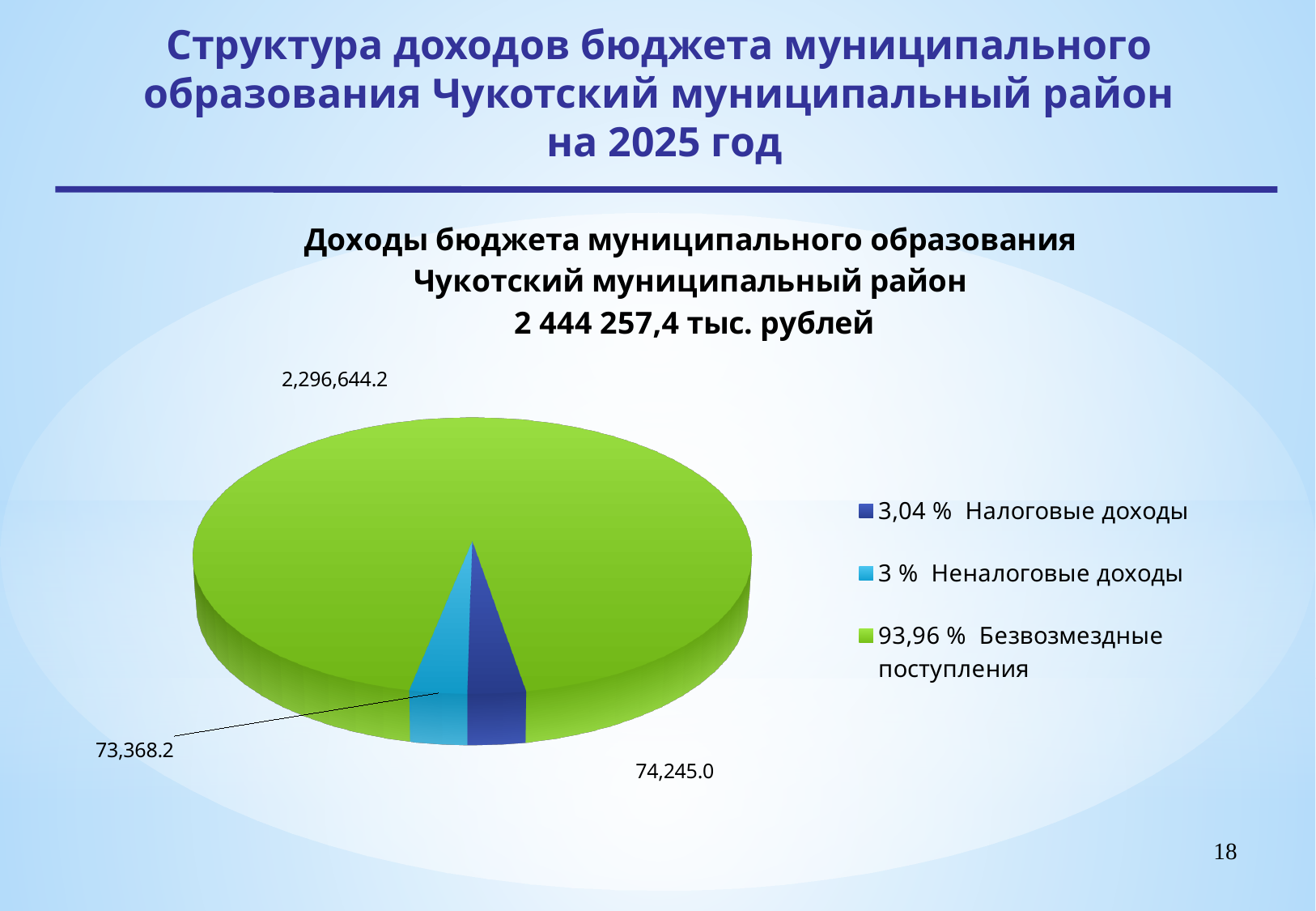
What is the value shown for Безвозмездные поступления? 2,296,644.2 What is the difference between the values for Налоговые доходы and Неналоговые доходы? 876.8 How many slices does the pie chart have? 3 What is the value shown for Налоговые доходы? 74,245.0 What share of the pie does Безвозмездные поступления represent? 93,96 % What share of the pie does Налоговые доходы represent? 3,04 % What total amount is stated in the chart title? 2 444 257,4 тыс. рублей Which category has the largest slice of the pie? Безвозмездные поступления What is the value shown for Неналоговые доходы? 73,368.2 What kind of chart is shown on the slide? pie chart How many entries does the legend of the pie chart list? 3 Which category has the smallest slice of the pie? Неналоговые доходы